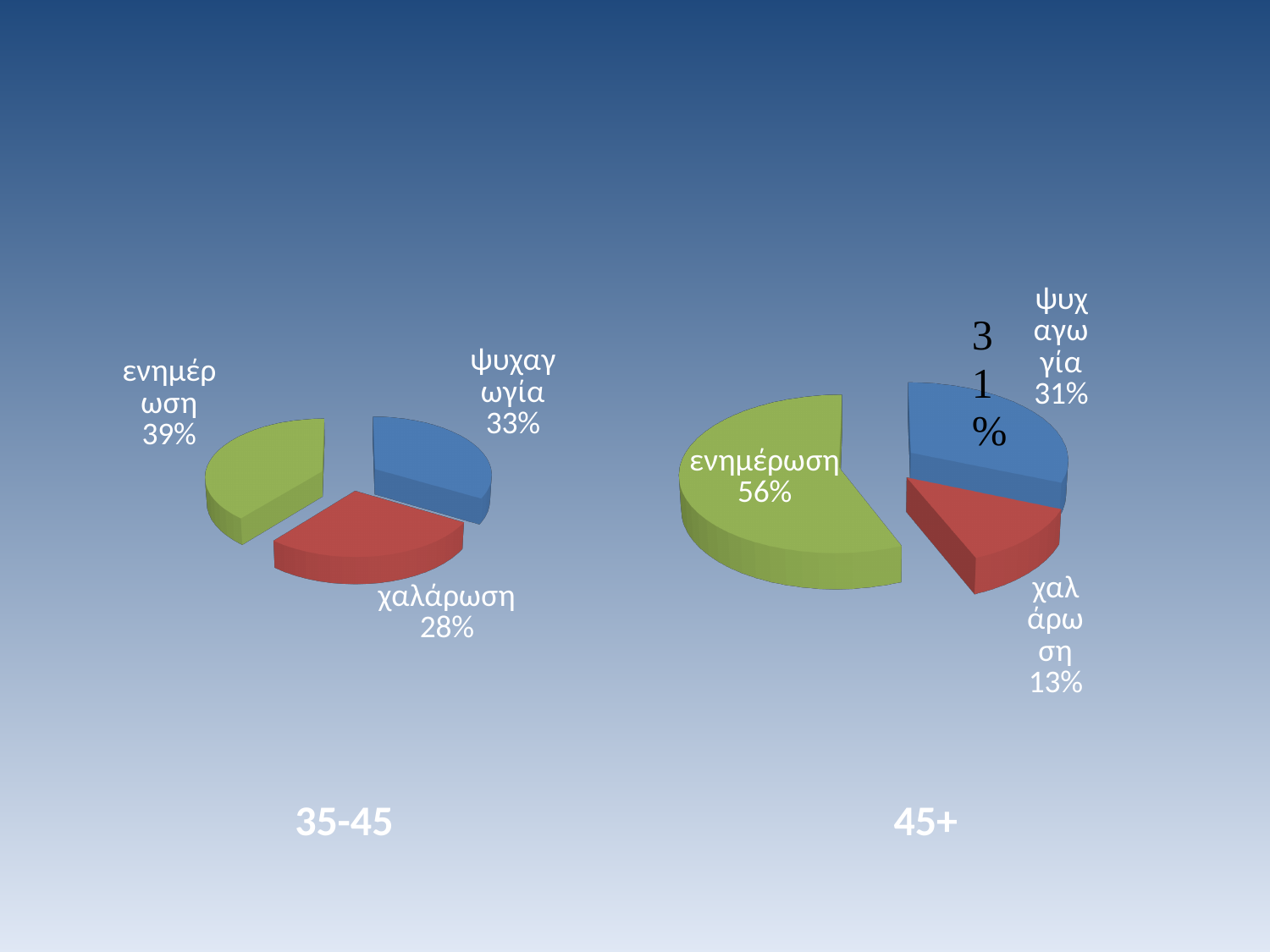
In the 45+ chart, what share does χαλάρωση have? 13% In the 35-45 chart, what share does χαλάρωση have? 28% In the 35-45 chart, which is larger, ενημέρωση or ψυχαγωγία? ενημέρωση In the 45+ chart, what is the difference between the shares of ενημέρωση and χαλάρωση? 43% In the 35-45 chart, which category has the smallest slice? χαλάρωση In the 45+ chart, which category has the smallest slice? χαλάρωση In the 35-45 chart, what share does ενημέρωση have? 39% In the 45+ chart, which category has the largest slice? ενημέρωση How many slices does the 35-45 chart have? 3 What type of chart is the 45+ chart? pie chart